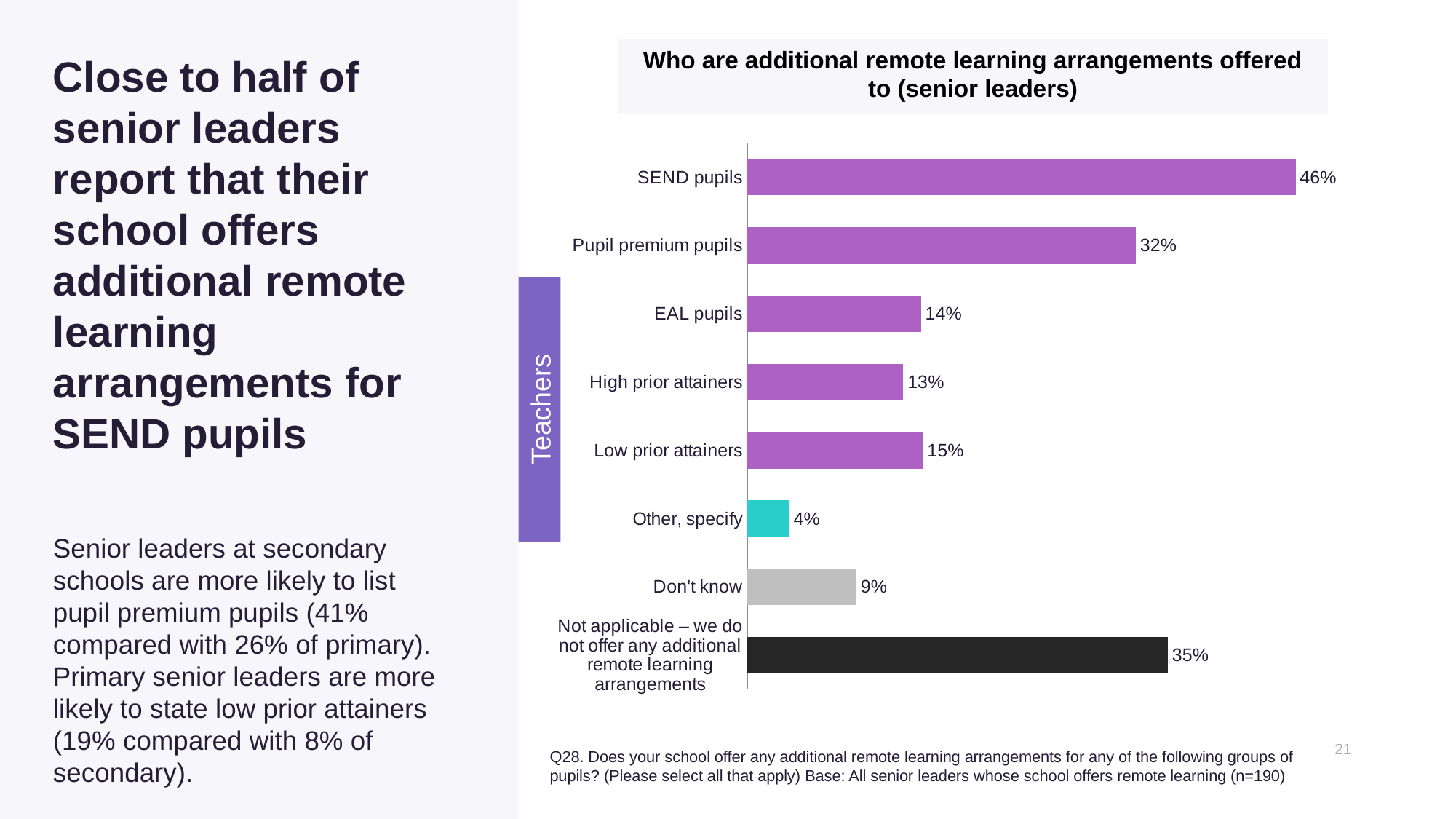
What percentage of senior leaders say additional remote learning arrangements are offered to SEND pupils? 46% What is the value shown for Pupil premium pupils? 32% What is the difference between the values for EAL pupils and Other, specify? 10 percentage points Which category has the lowest value in the chart? Other, specify What is the title of the chart? Who are additional remote learning arrangements offered to (senior leaders) What is the difference between the values for SEND pupils and Pupil premium pupils? 14 percentage points What percentage is shown for the 'Not applicable – we do not offer any additional remote learning arrangements' category? 35% Which category has the highest value in the chart? SEND pupils What is the value for 'Don't know'? 9% How many categories are plotted in the chart? 8 What type of chart is shown on the slide? Bar chart Which is larger, the value for Low prior attainers or the value for High prior attainers? Low prior attainers